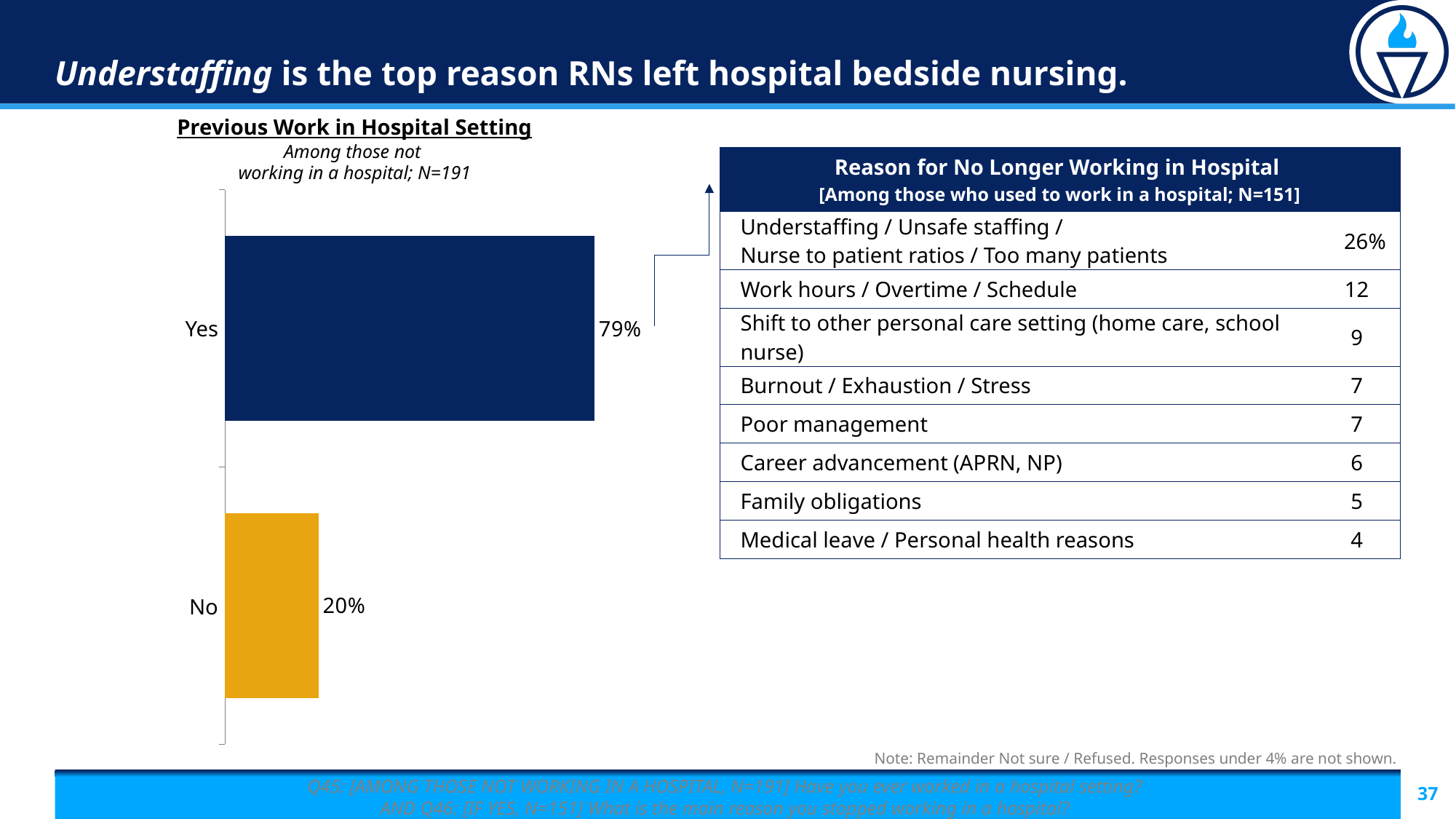
What is the sample size (N) stated under the Previous Work in Hospital Setting chart title? N=191 What is the difference between the Yes and No values in the Previous Work in Hospital Setting chart? 59% Which category has the highest value in the Previous Work in Hospital Setting chart? Yes In the Previous Work in Hospital Setting chart, which is larger, Yes or No? Yes What is the value for Yes in the Previous Work in Hospital Setting chart? 79% What kind of chart is the Previous Work in Hospital Setting chart? Bar chart What is the value for No in the Previous Work in Hospital Setting chart? 20% How many categories are shown in the Previous Work in Hospital Setting chart? 2 What is the title of the chart on the left of the slide? Previous Work in Hospital Setting Which category has the lowest value in the Previous Work in Hospital Setting chart? No